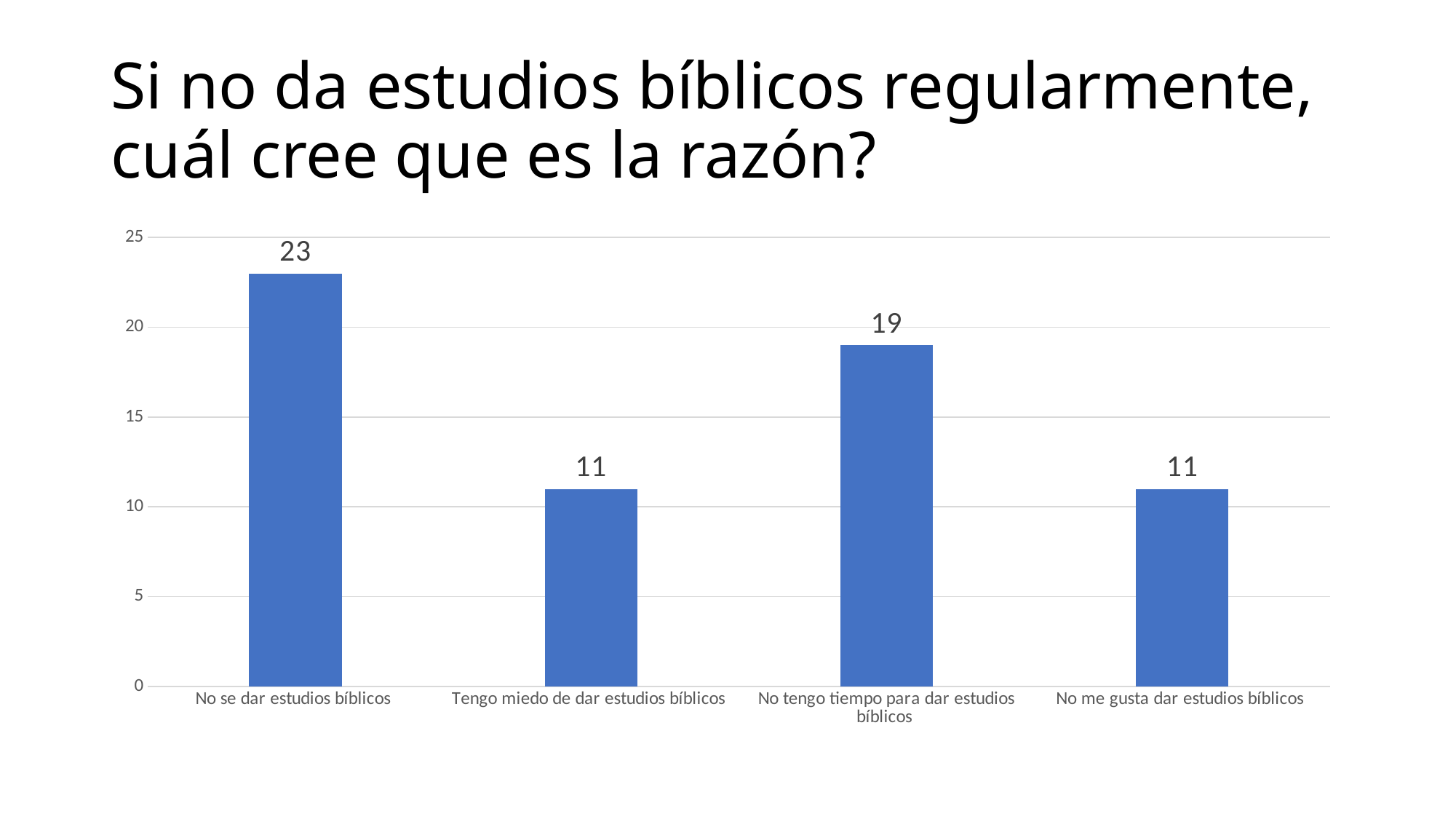
What is the title of the slide containing the chart? Si no da estudios bíblicos regularmente, cuál cree que es la razón? How many categories are shown in the chart? 4 What is the value for "No tengo tiempo para dar estudios bíblicos"? 19 What is the value for "No se dar estudios bíblicos"? 23 What is the value for "Tengo miedo de dar estudios bíblicos"? 11 What is the difference between the values for "No se dar estudios bíblicos" and "No tengo tiempo para dar estudios bíblicos"? 4 What is the difference between the values for "No tengo tiempo para dar estudios bíblicos" and "No me gusta dar estudios bíblicos"? 8 Which is larger, the value for "No se dar estudios bíblicos" or the value for "No tengo tiempo para dar estudios bíblicos"? No se dar estudios bíblicos Is the value for "No tengo tiempo para dar estudios bíblicos" greater or less than 15? greater Is the value for "No me gusta dar estudios bíblicos" greater or less than 15? less What kind of chart is shown on the slide? bar chart Which category has the highest value? No se dar estudios bíblicos